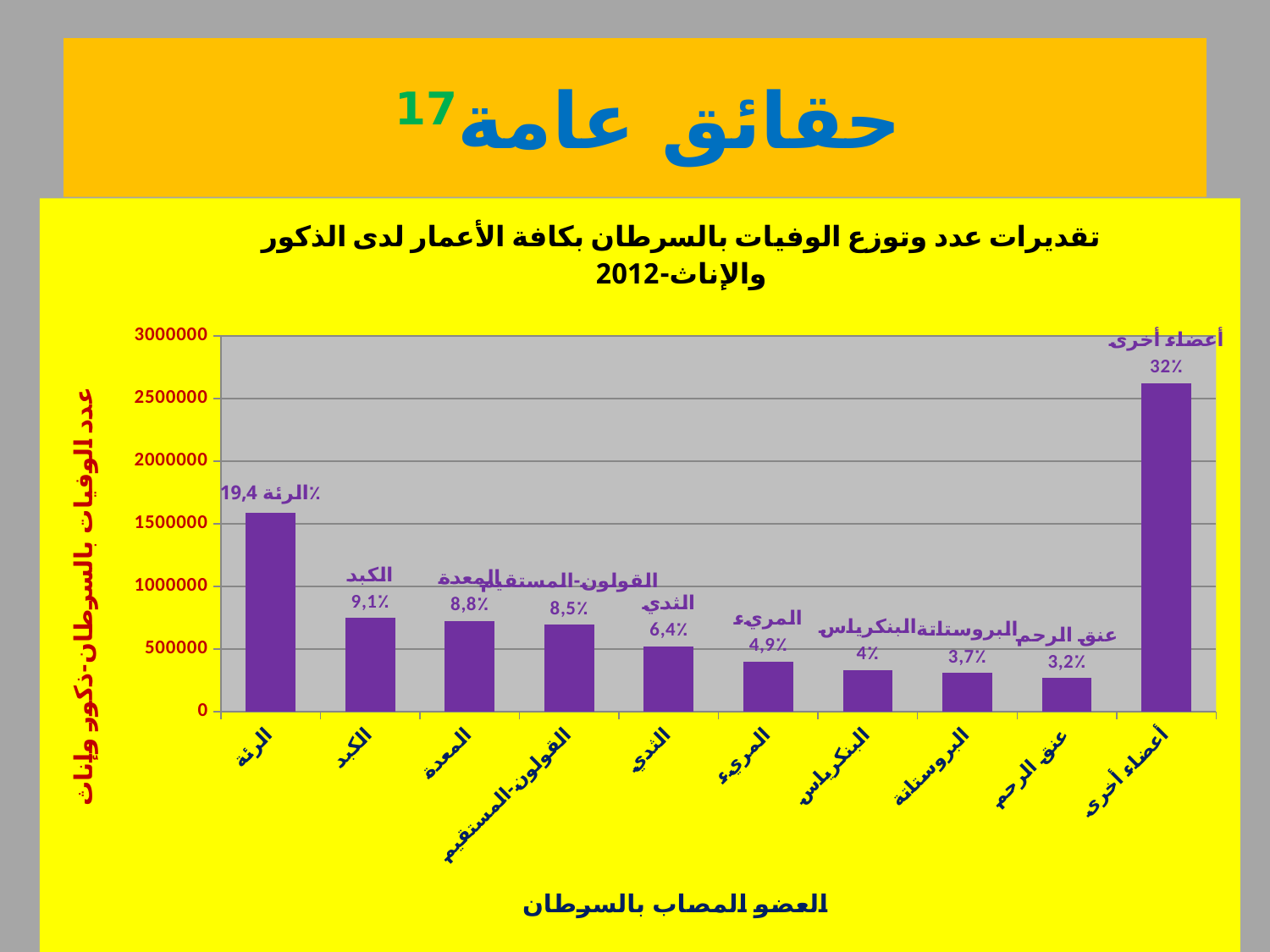
Which bar is taller, الثدي or المريء? الثدي What percentage label is shown for الكبد (liver)? 9,1% Which category has the lowest bar? عنق الرحم What percentage label is shown for الرئة (lung)? 19,4% Is the number of deaths for الرئة greater or less than 1500000? greater What percentage label is shown for أعضاء أخرى (other organs)? 32% Which category has the highest bar? أعضاء أخرى What is the label of the x axis? العضو المصاب بالسرطان What percentage label is shown for عنق الرحم (cervix)? 3,2% Is the number of deaths for الكبد greater or less than 1000000? less How many categories (organs) are plotted on the x axis? 10 What type of chart is shown on the slide? bar chart